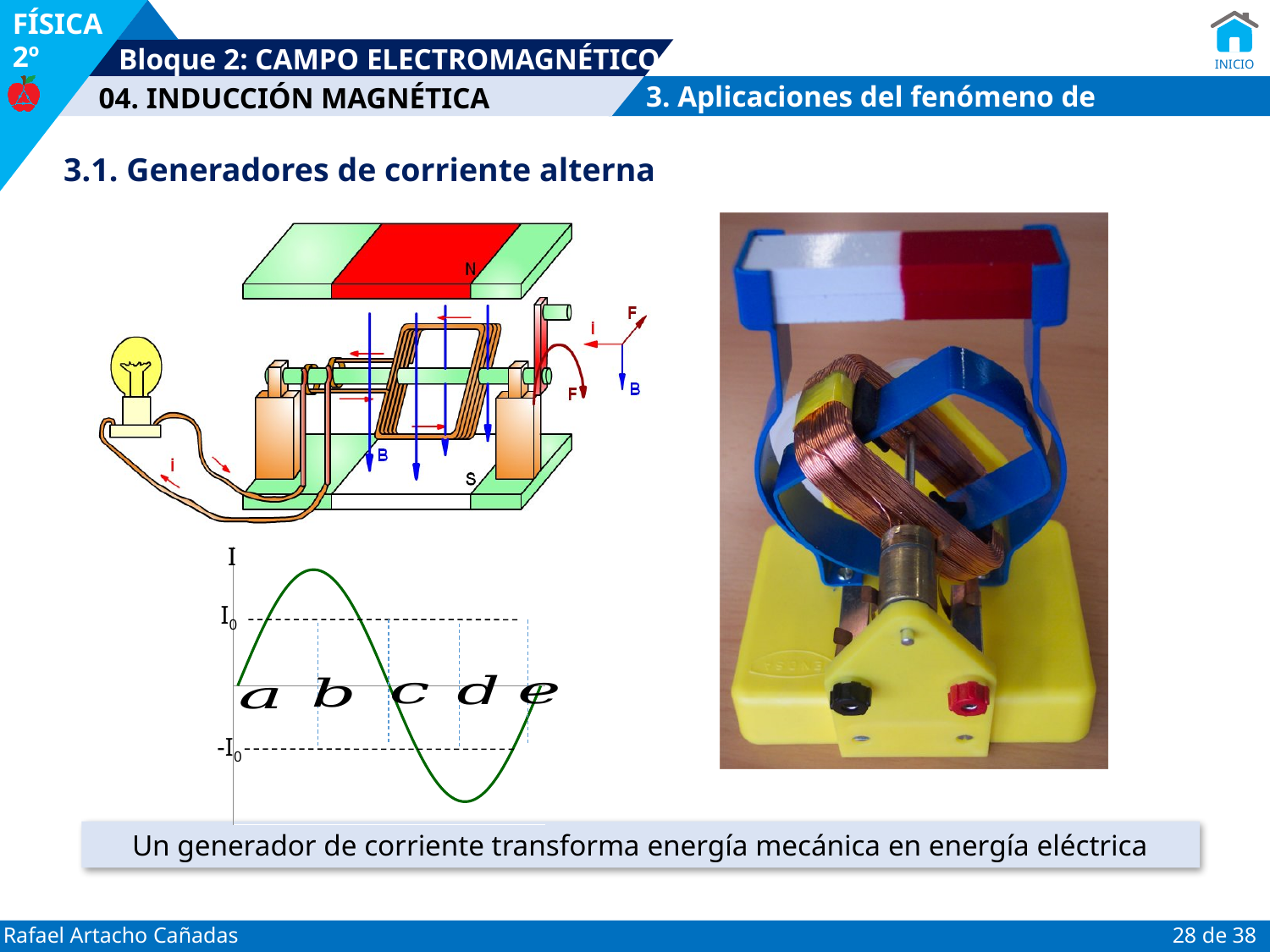
At which labelled point does the current graph reach its maximum value? b What colour is the curve plotted on the current graph? green Which is larger on the graph, the current at point b or the current at point d? b Does the current rise or fall between points b and d on the graph? fall At which labelled point does the current graph reach its minimum value? d Does the current rise or fall between points a and b on the graph? rise What is the value of the current at point b on the graph? I0 What kind of chart is the graph below the generator diagram? line chart What is the value of the current at point d on the graph? -I0 What quantity is plotted on the vertical axis of the graph below the generator diagram? I How many labelled points (a, b, c, d, e) are marked along the horizontal axis of the current graph? 5